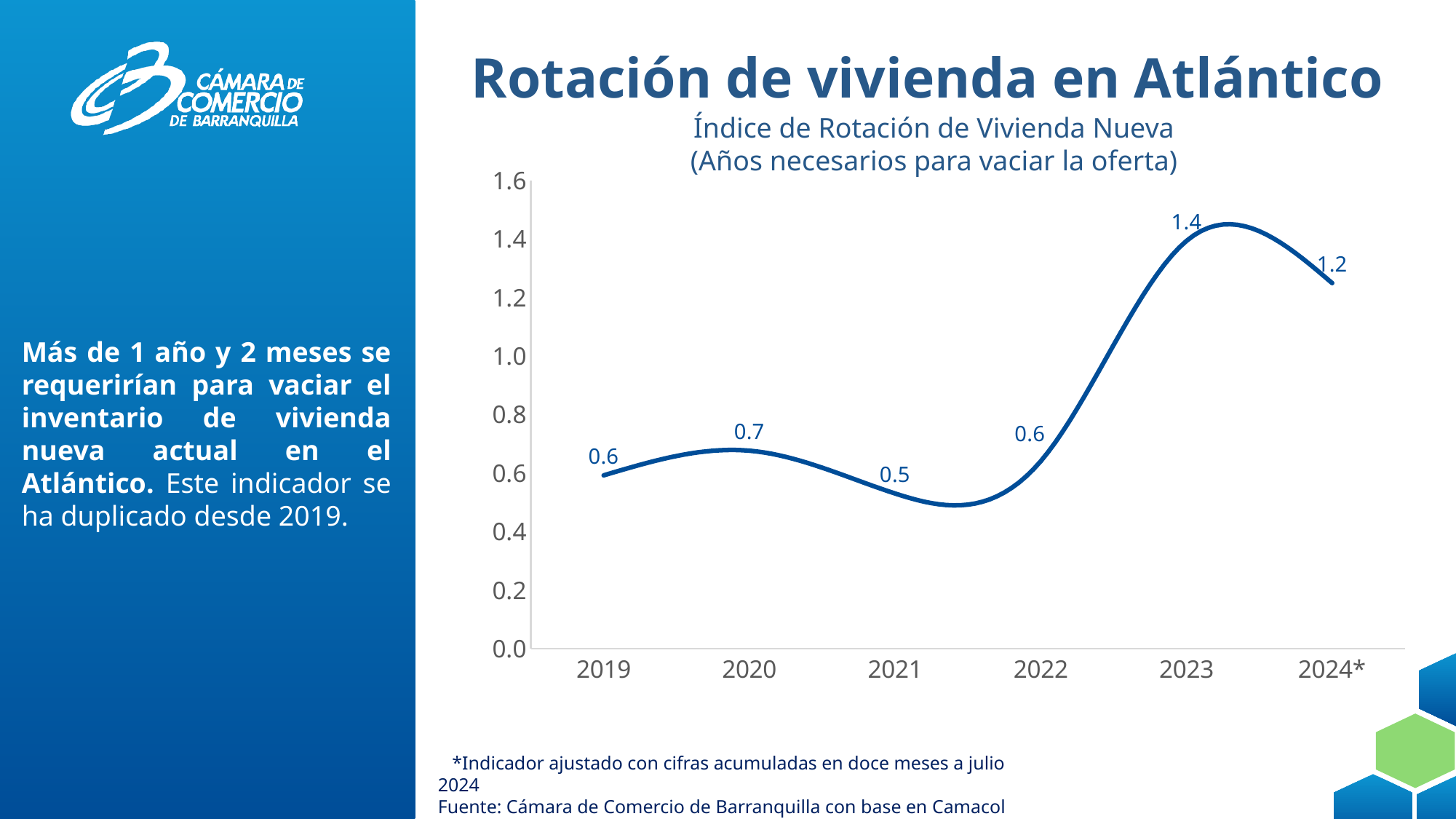
What is the value of the Índice de Rotación de Vivienda Nueva for 2019? 0.6 What is the value of the index for 2023? 1.4 Is the value for 2023 greater or less than 1.0? greater Which year has the highest value on the chart? 2023 What is the difference between the values for 2023 and 2019? 0.8 What is the value of the index for 2024*? 1.2 Which is larger, the value for 2020 or the value for 2022? 2020 Which year has the lowest value on the chart? 2021 What is the value of the index for 2021? 0.5 Does the value rise or fall from 2022 to 2023? rise How many years are plotted on the x axis? 6 What kind of chart is shown on the slide? line chart